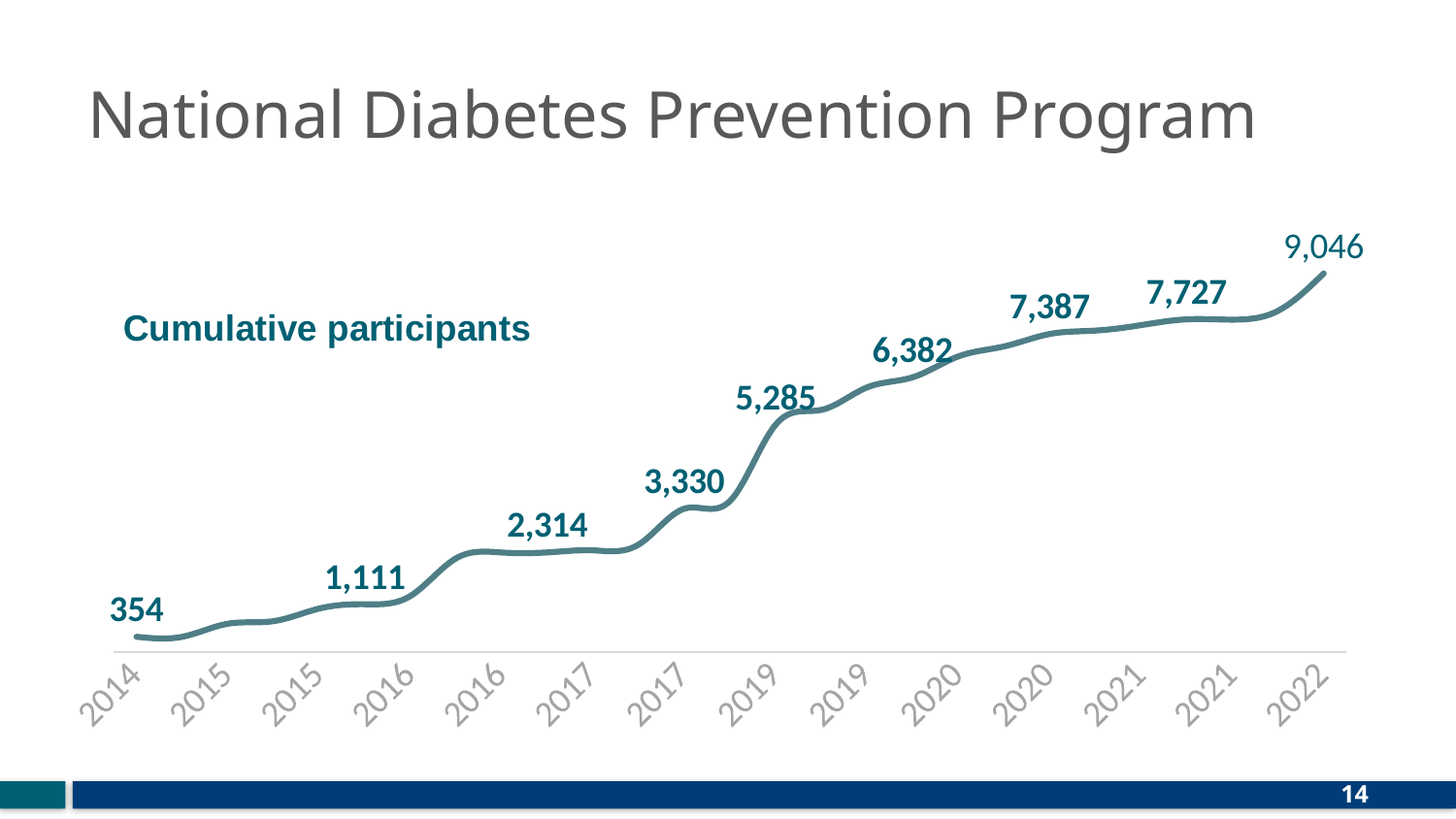
What is the difference between the labelled values 7,727 and 7,387? 340 What is the difference between the value labelled at 2022 and the value labelled at 2014? 8,692 What does the chart's label say the line represents? Cumulative participants How many data labels are printed on the line? 9 What kind of chart is shown on the slide? line chart What is the value of cumulative participants labelled at 2014? 354 What is the lowest value labelled on the chart? 354 Do the values rise or fall from 2014 to 2022 along the x axis? rise What is the highest value labelled on the chart? 9,046 Which is larger, the value labelled 5,285 or the value labelled 3,330? 5,285 How many x-axis labels (data points) are shown on the chart? 14 What is the value of cumulative participants labelled at 2022? 9,046